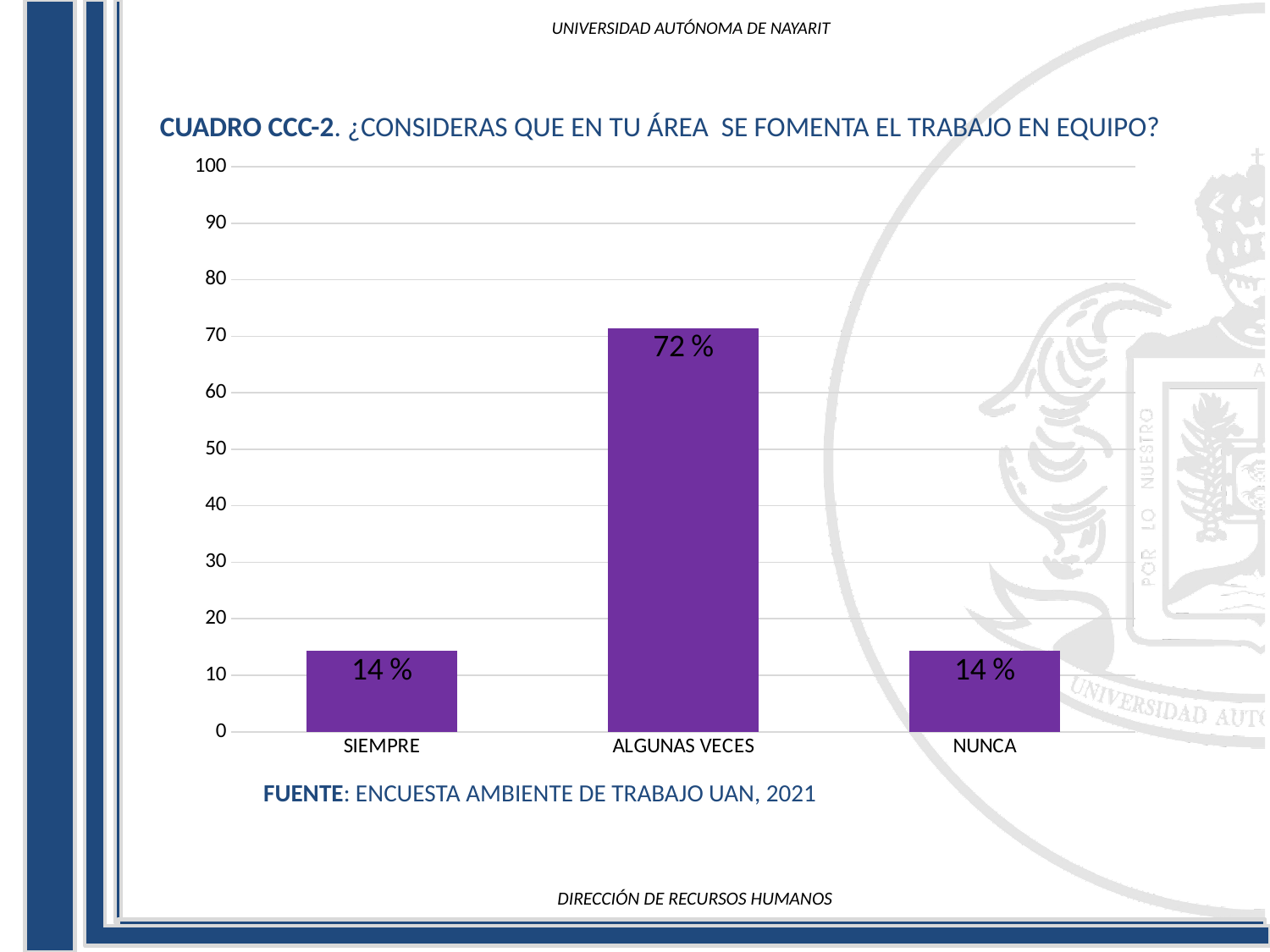
Is the value for ALGUNAS VECES greater or less than 50? greater What is the value for NUNCA? 14 % Is the value for SIEMPRE greater or less than 20? less What is the value for ALGUNAS VECES? 72 % Which category has the highest value? ALGUNAS VECES What kind of chart is shown on the slide? bar chart What is the maximum value shown on the y axis? 100 What is the source cited below the chart? ENCUESTA AMBIENTE DE TRABAJO UAN, 2021 What is the difference between the values for ALGUNAS VECES and SIEMPRE? 58 % Which is larger, the value for ALGUNAS VECES or the value for NUNCA? ALGUNAS VECES What is the value for SIEMPRE? 14 % How many categories are shown on the x axis? 3